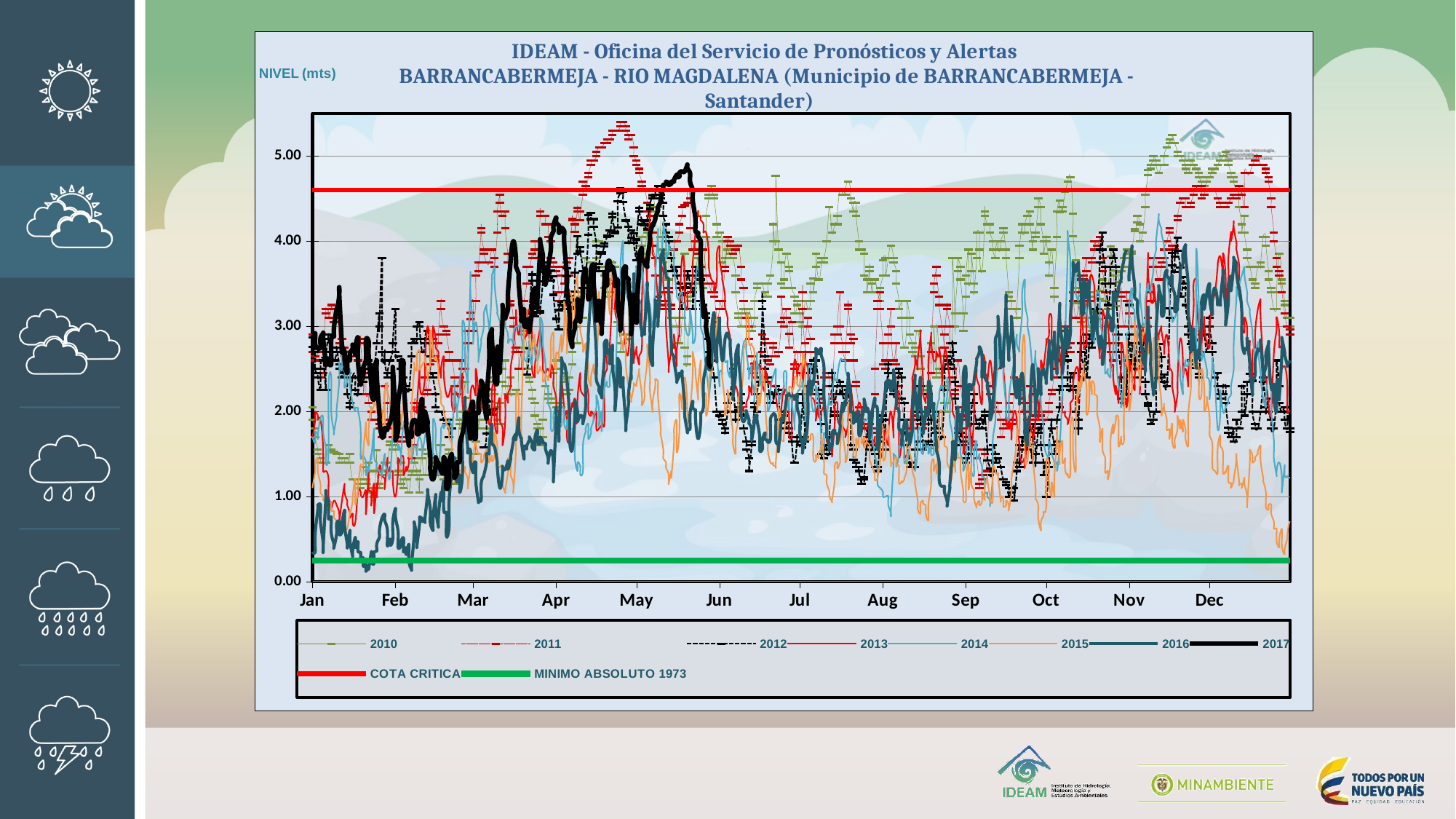
What is the highest tick value shown on the y axis? 5.00 Is the value of the 2017 series at the start of January greater or less than 2.00? greater How many months are labelled along the x axis? 12 Is the COTA CRITICA line greater or less than 4.00? greater Is the MINIMO ABSOLUTO 1973 line greater or less than 1.00? less Does the 2017 series rise or fall between mid-May and June? fall How many series does the legend list? 10 What kind of chart is shown on the slide? Line chart What label is given to the y axis of the chart? NIVEL (mts)